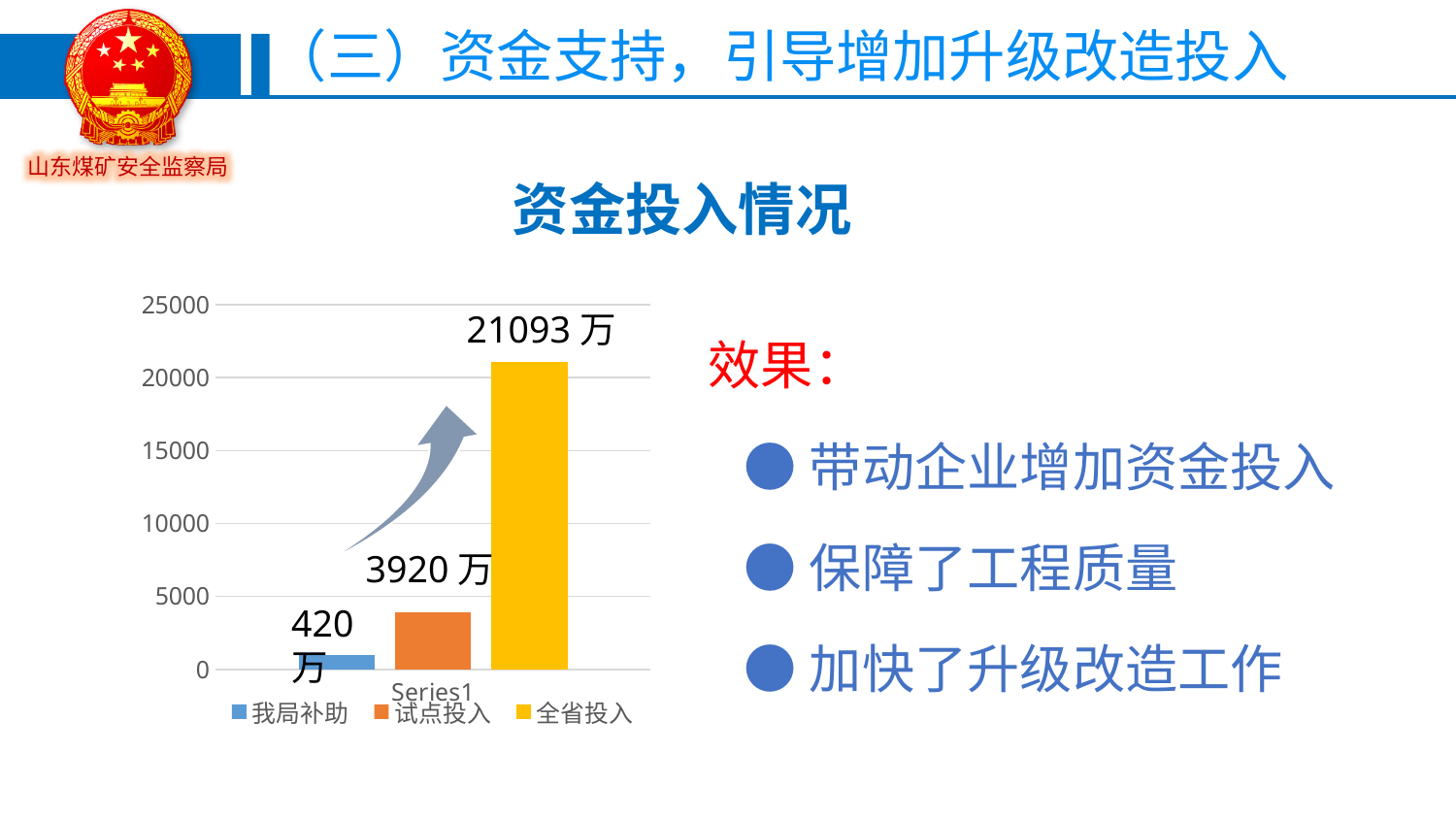
How many series does the legend list? 3 What is the difference between the values for 试点投入 and 我局补助? 3500 万 Which is larger, the value for 试点投入 or the value for 我局补助? 试点投入 Is the value for 全省投入 greater or less than 20000? greater Which series has the lowest value in the chart? 我局补助 What is the value for 我局补助 in the chart? 420 万 Which series has the highest value in the chart? 全省投入 What is the value for 全省投入 in the chart? 21093 万 What is the value for 试点投入 in the chart? 3920 万 What is the title of the chart? 资金投入情况 What kind of chart is shown on the slide? bar chart What is the difference between the values for 全省投入 and 试点投入? 17173 万